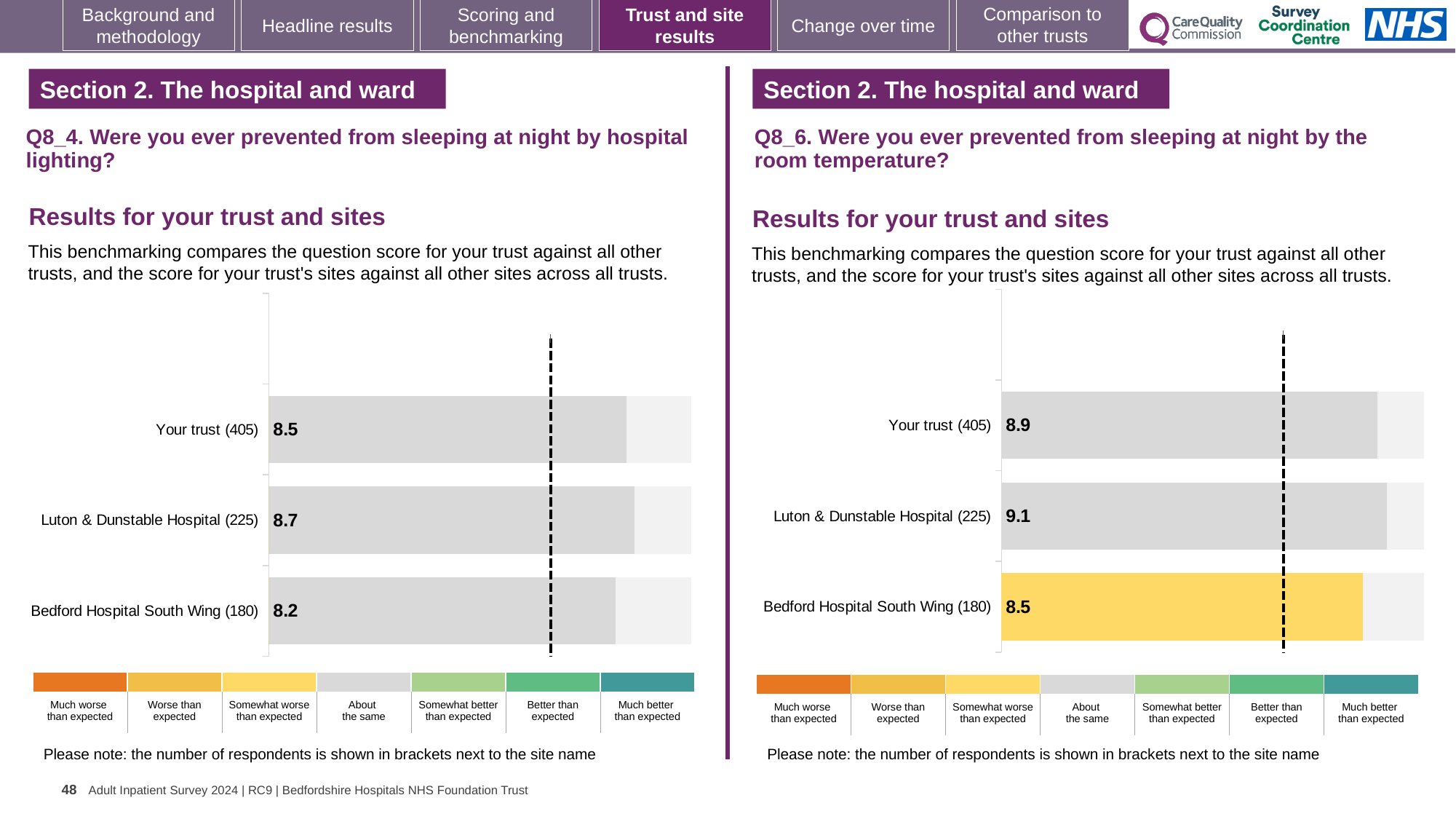
In the Q8_4 chart (hospital lighting), what is the score for Your trust (405)? 8.5 How many bars are plotted in the Q8_4 chart (hospital lighting)? 3 In the Q8_6 chart (room temperature), what is the score for Your trust (405)? 8.9 In the Q8_6 chart (room temperature), which site or trust has the lowest score? Bedford Hospital South Wing (180) In the Q8_4 chart (hospital lighting), what is the difference between the Luton & Dunstable Hospital score and the Bedford Hospital South Wing score? 0.5 What type of chart is used for the Q8_6 results (room temperature)? Bar chart In the Q8_6 chart (room temperature), what is the score for Bedford Hospital South Wing (180)? 8.5 In the Q8_6 chart (room temperature), what is the difference between the Luton & Dunstable Hospital score and the Your trust score? 0.2 In the Q8_6 chart (room temperature), what is the score for Luton & Dunstable Hospital (225)? 9.1 In the Q8_4 chart (hospital lighting), what is the score for Bedford Hospital South Wing (180)? 8.2 In the Q8_4 chart (hospital lighting), which site or trust has the highest score? Luton & Dunstable Hospital (225) In the Q8_4 chart (hospital lighting), what is the score for Luton & Dunstable Hospital (225)? 8.7